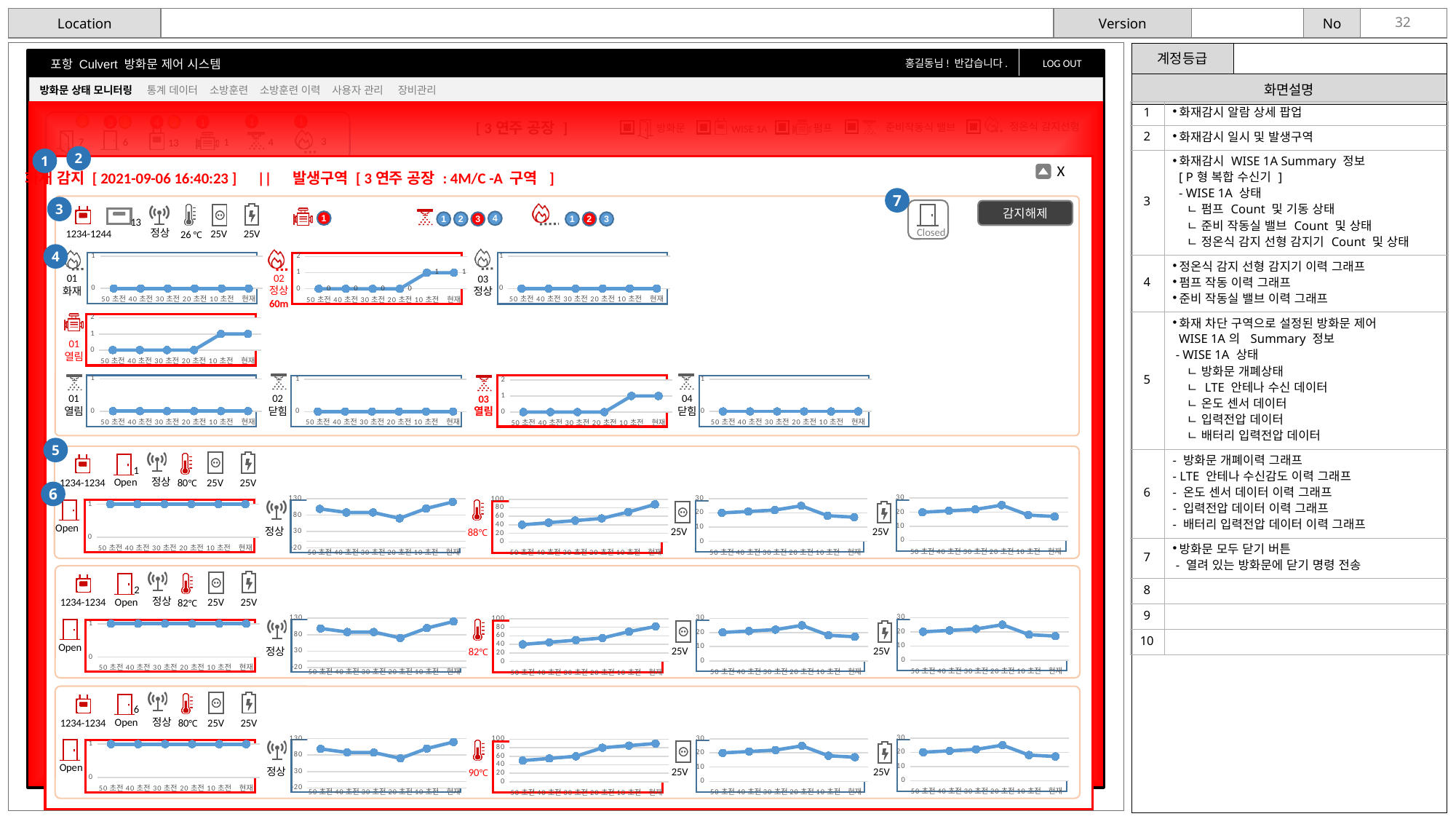
What kind of chart is used for the 펌프 01 열림 history in the top section? line chart What is the label of the last point on the x axis of the door Open history charts? 현재 In the red-bordered 정온식 감지기 02 chart in the top section, what is the value at 50 초전? 0 In the temperature (88℃) chart of the first door row (door 1), do the values rise or fall from 50 초전 to 현재? rise In the LTE signal (정상) chart of the first door row (door 1), is the value at 20 초전 greater or less than 80? less How many time points are plotted on the x axis of the 정온식 감지기 02 chart (the red-bordered chart in the top section)? 6 In the 펌프 01 열림 chart in the top section, do the values rise or fall from 50 초전 to 현재? rise In the red-bordered 정온식 감지기 02 chart in the top section, what is the value at 현재? 1 In the temperature (88℃) chart of the first door row (door 1), at which time point is the value highest? 현재 In the 준비작동실 밸브 03 열림 chart (red-bordered) in the top section, which is larger: the value at 현재 or the value at 50 초전? 현재 In the red-bordered 정온식 감지기 02 chart in the top section, what is the difference between the value at 현재 and the value at 50 초전? 1 In the temperature (88℃) chart of the first door row (door 1), is the value at 현재 greater or less than 60? greater